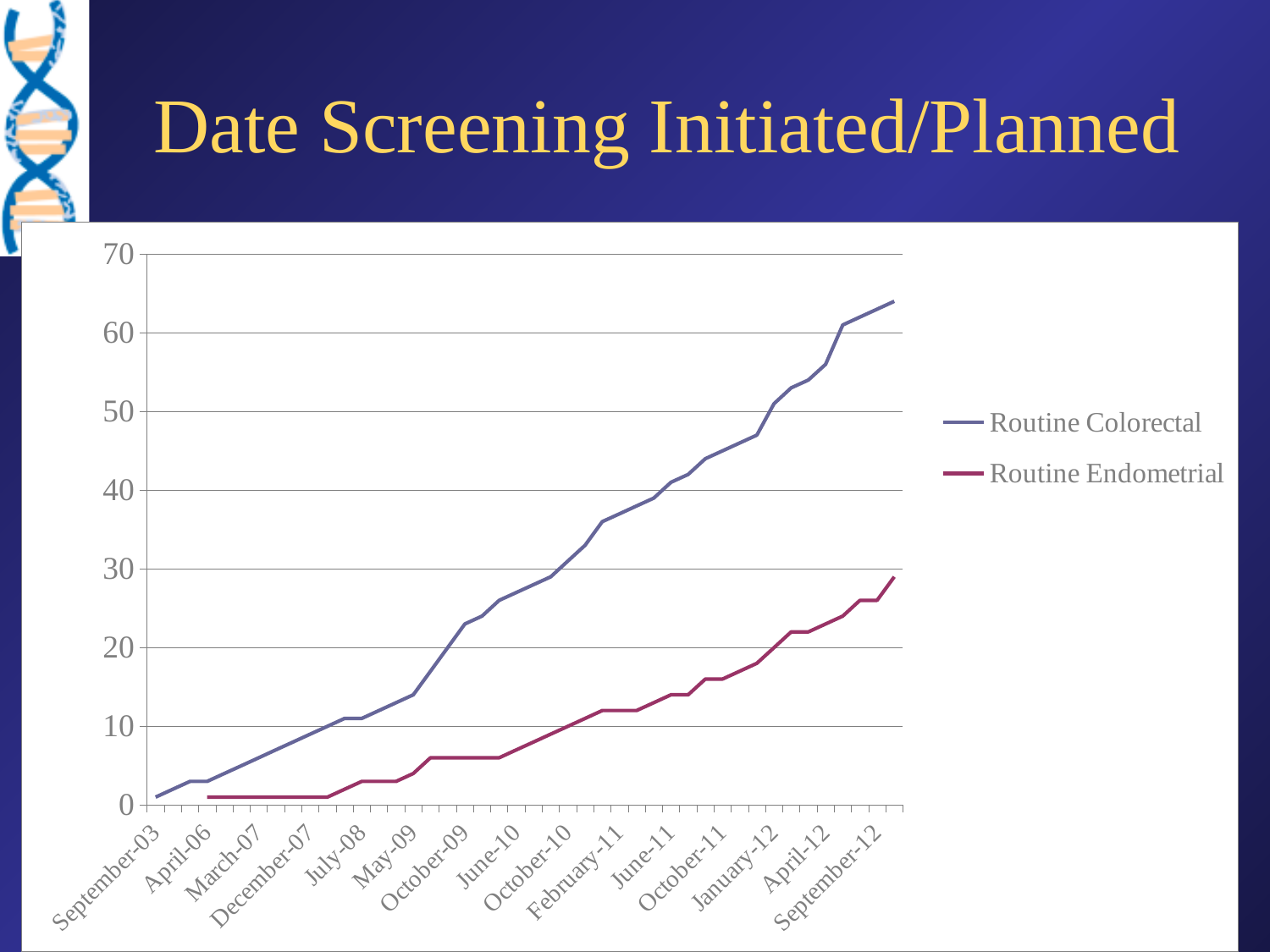
What is the title of the slide? Date Screening Initiated/Planned Which series has the higher value at September-12, Routine Colorectal or Routine Endometrial? Routine Colorectal Is the value for Routine Endometrial at September-12 greater or less than 20? greater How many series does the legend list? 2 Is the value for Routine Endometrial at October-09 greater or less than 10? less Is the value for Routine Colorectal at September-12 greater or less than 60? greater What kind of chart is shown on the slide? line chart Do the values for Routine Endometrial rise or fall across the x axis? rise Do the values for Routine Colorectal rise or fall from September-03 to September-12? rise Which series is drawn in the dark red line? Routine Endometrial